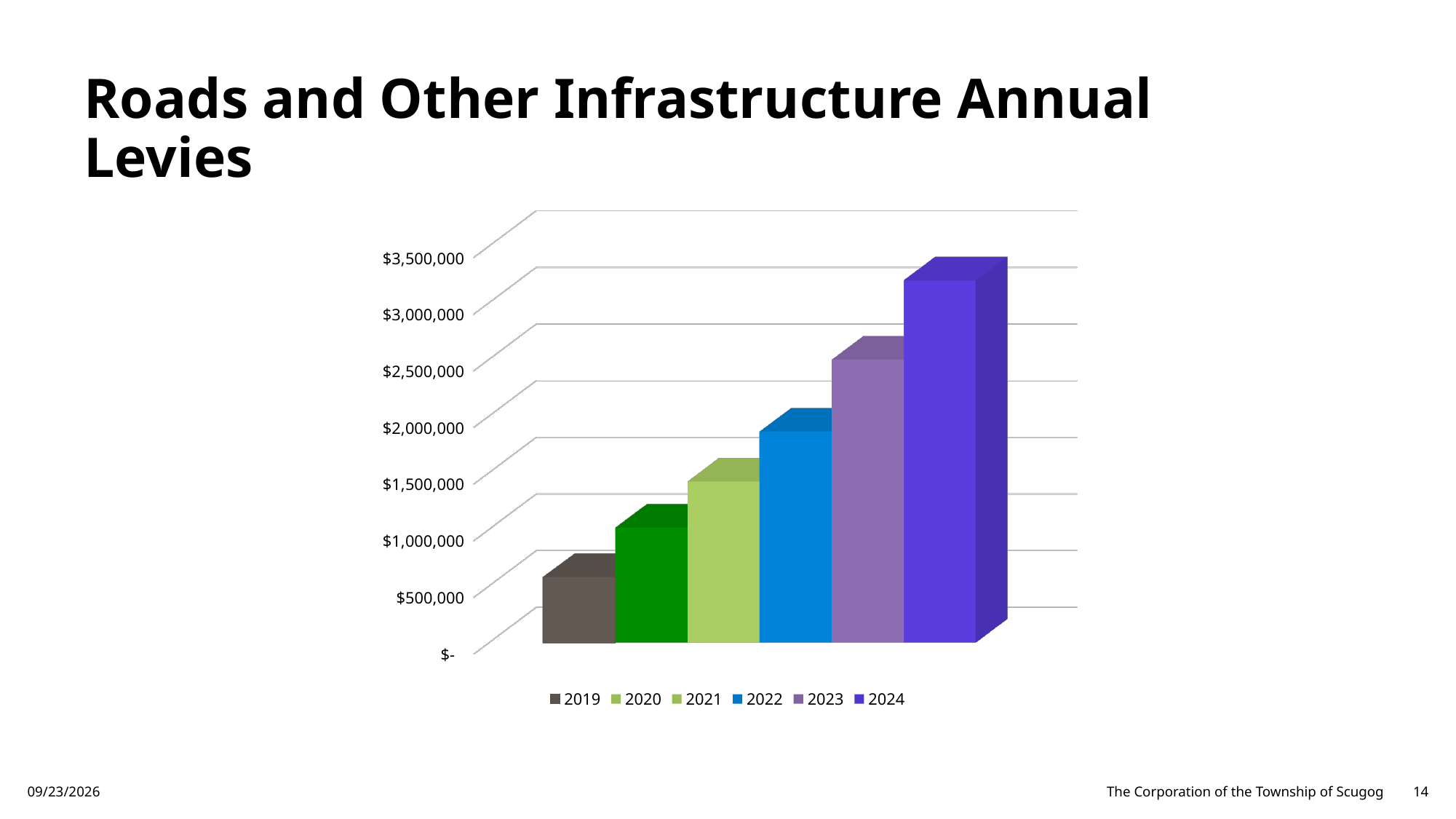
How many entries does the legend list? 6 What is the title of the slide containing the chart? Roads and Other Infrastructure Annual Levies How many bars are plotted in the chart? 6 What kind of chart is shown on the slide? Bar chart Which year has the lowest annual levy in the chart? 2019 Do the annual levies rise or fall from 2019 to 2024? Rise Is the value for 2021 greater or less than $1,000,000? greater Is the value for 2019 greater or less than $1,000,000? less Is the value for 2024 greater or less than $3,500,000? less Which is larger, the levy for 2023 or the levy for 2021? 2023 Which year has the highest annual levy in the chart? 2024